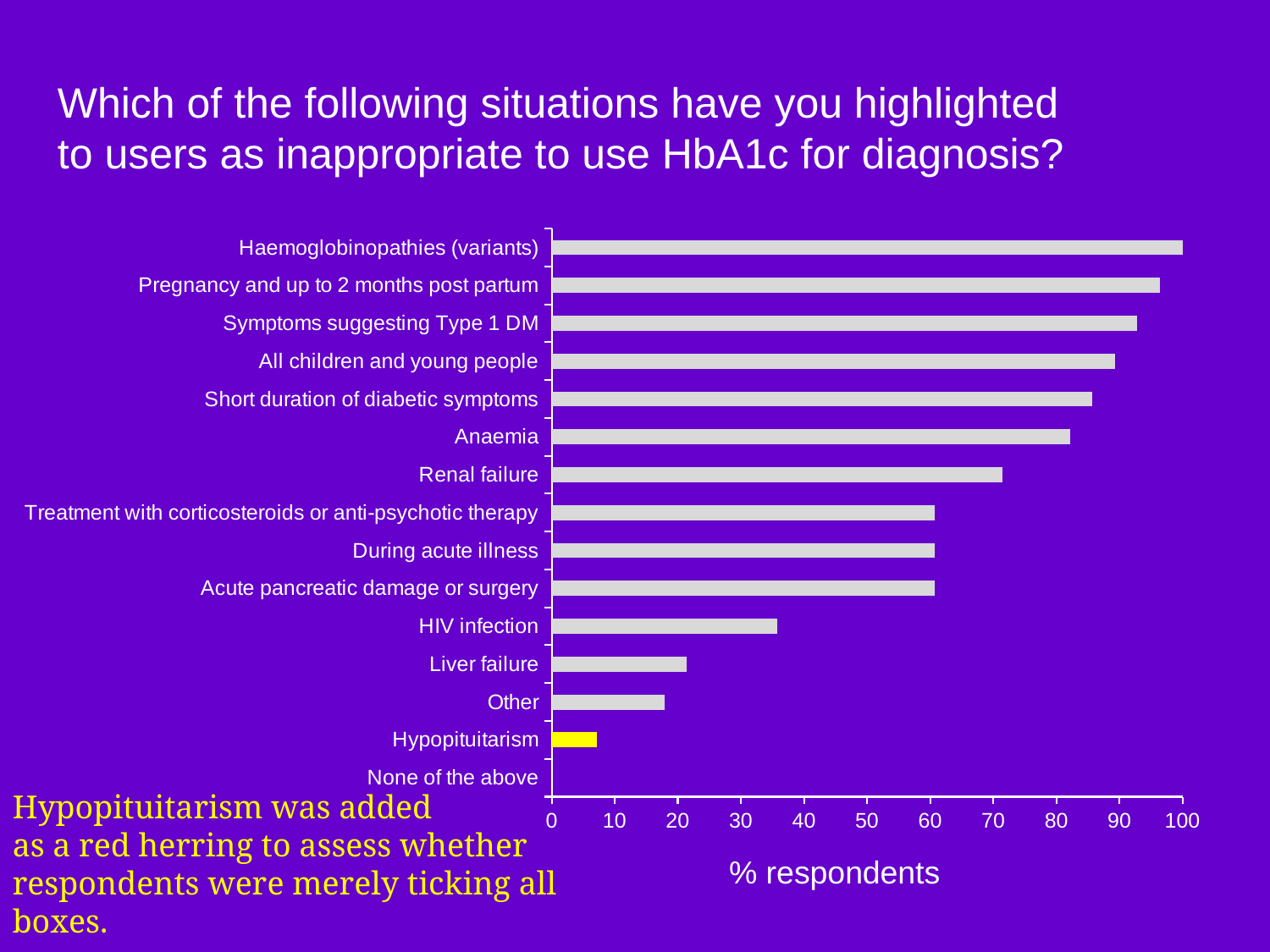
Is the value for Anaemia greater or less than 80? greater Which category's bar is coloured yellow? Hypopituitarism How many categories are listed on the chart? 15 Which category has the lowest percentage of respondents? None of the above What is the value for Haemoglobinopathies (variants)? 100 Is the value for Pregnancy and up to 2 months post partum greater or less than 90? greater Is the value for Liver failure greater or less than 30? less Which category has the highest percentage of respondents? Haemoglobinopathies (variants) Which is larger, the value for Renal failure or the value for HIV infection? Renal failure What is the label on the horizontal axis? % respondents What kind of chart is shown on the slide? bar chart